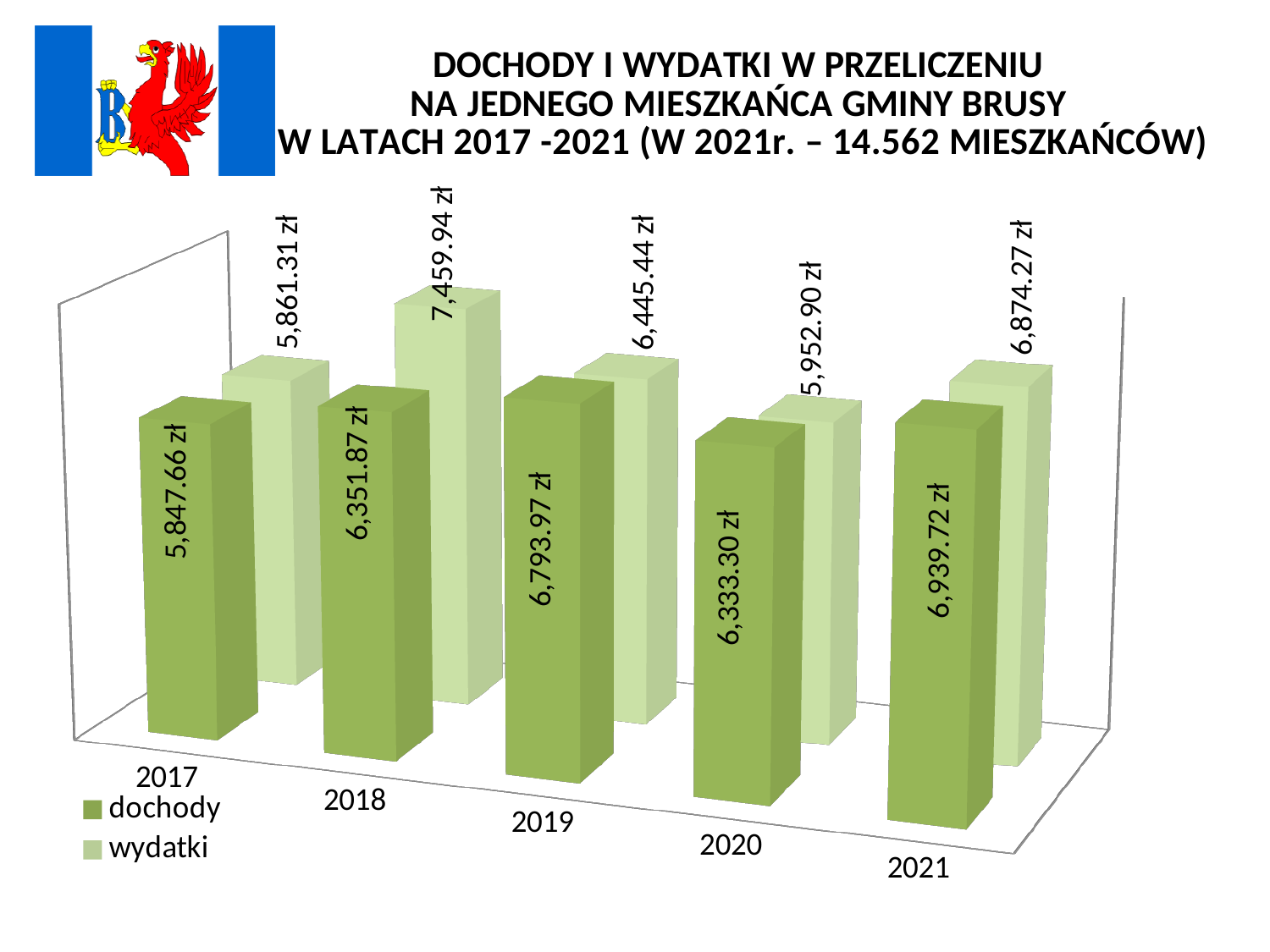
What is the value of wydatki for 2018? 7,459.94 zł In which year is dochody the highest? 2021 What kind of chart is shown on the slide? bar chart How many years are shown on the x axis? 5 How many series does the legend list? 2 Which is larger in 2021, dochody or wydatki? dochody What is the value of wydatki for 2020? 5,952.90 zł What is the value of dochody for 2021? 6,939.72 zł What is the value of dochody for 2019? 6,793.97 zł In which year is wydatki the highest? 2018 What is the difference between wydatki and dochody in 2018? 1,108.07 zł In which year is wydatki the lowest? 2017